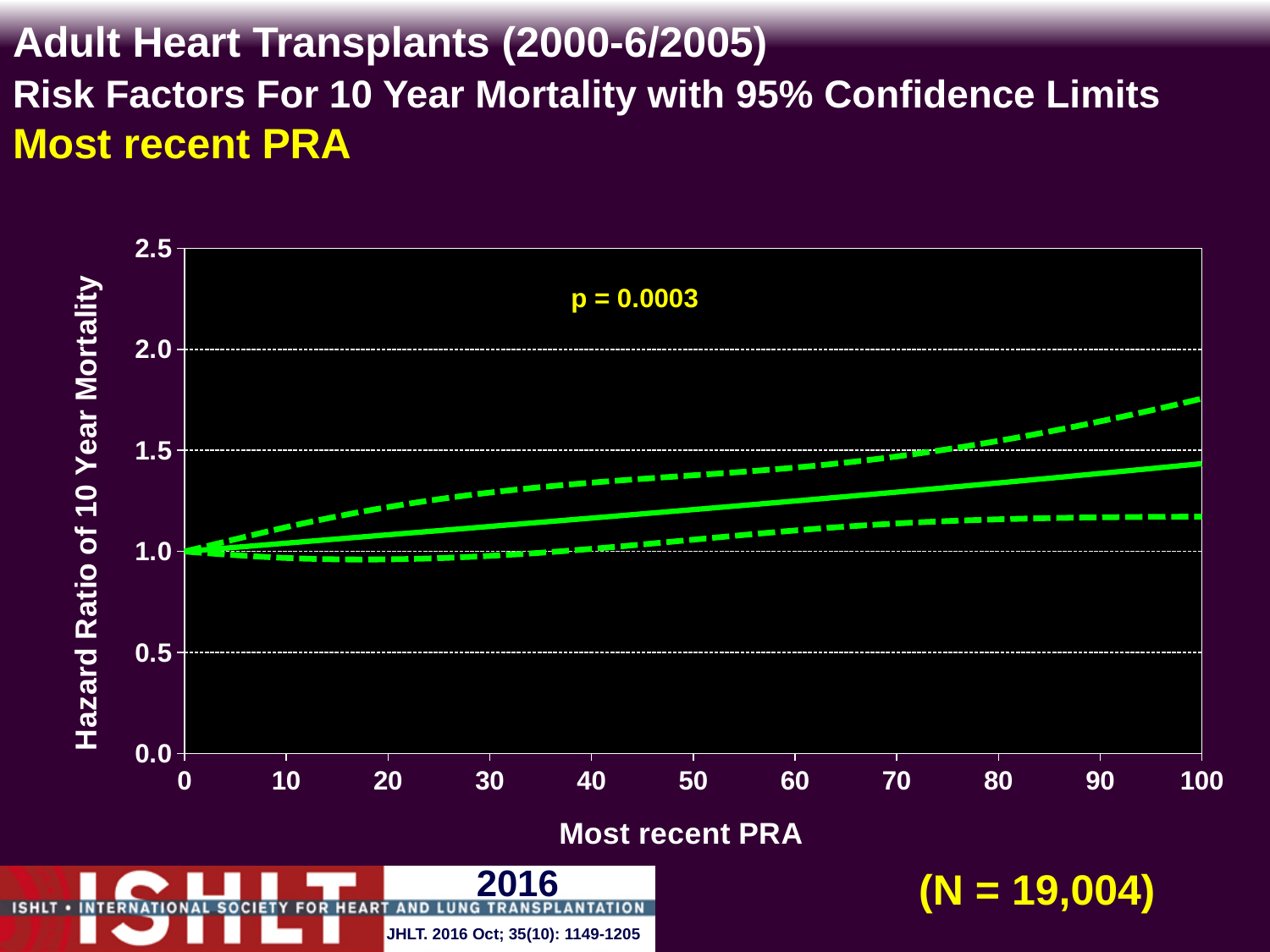
What is the sample size (N) shown on the slide? 19,004 Is the lower 95% confidence limit at a most recent PRA of 100 greater or less than 1.5? less What p-value is printed on the chart? p = 0.0003 Does the hazard ratio of 10 year mortality rise or fall as most recent PRA increases from 0 to 100? rise What is the highest value shown on the y axis? 2.5 Is the hazard ratio (solid line) at a most recent PRA of 50 greater or less than 1.5? less How many lines are plotted on the chart? 3 What is the label of the y axis? Hazard Ratio of 10 Year Mortality What is the hazard ratio of 10 year mortality at a most recent PRA of 0? 1.0 Is the hazard ratio (solid line) at a most recent PRA of 100 greater or less than 1.0? greater What kind of chart is shown on the slide? line chart